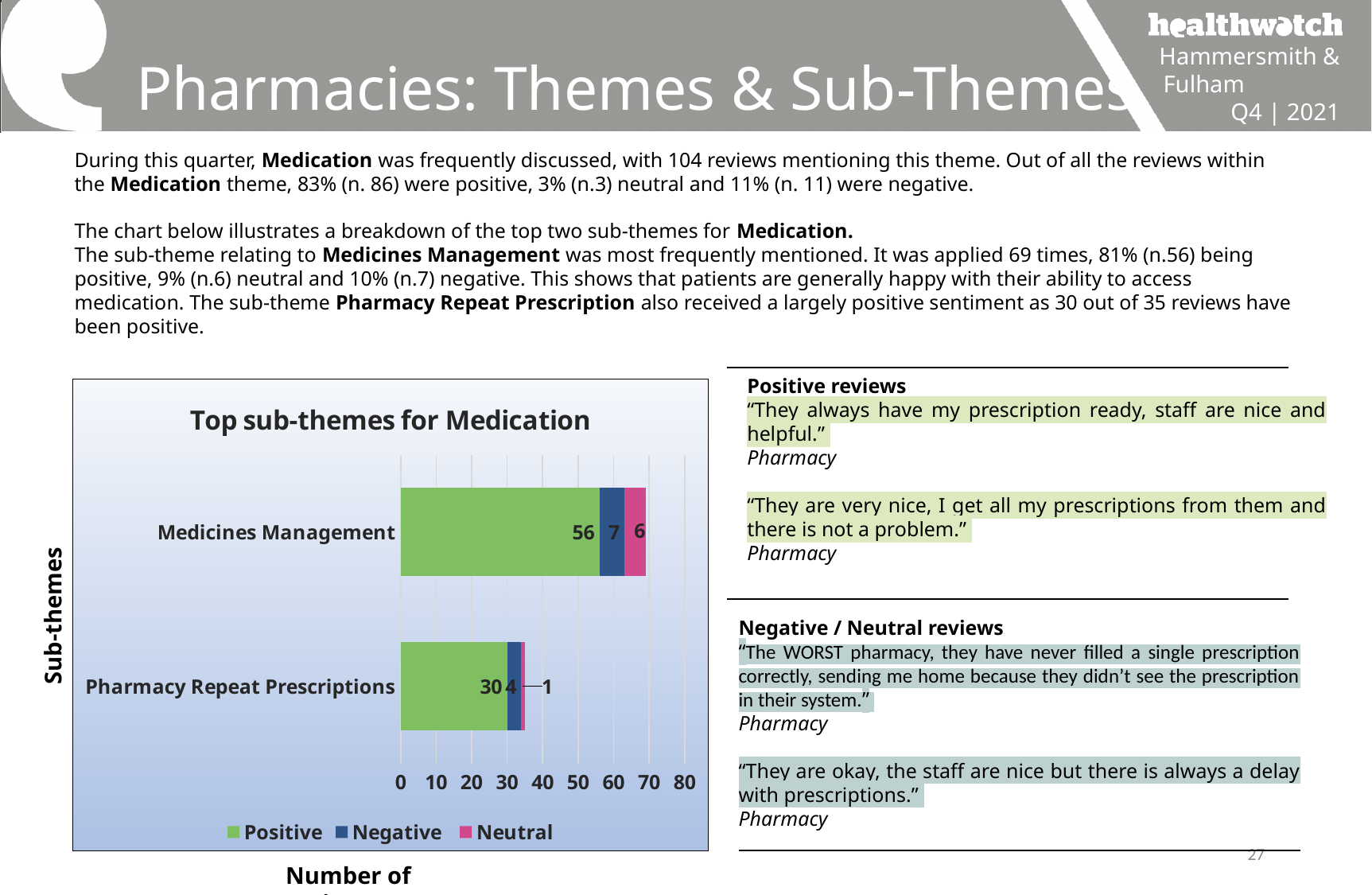
What is the total of the stacked bar for Medicines Management? 69 What is the title of the chart on the slide? Top sub-themes for Medication What is the Negative value for Pharmacy Repeat Prescriptions? 4 How many series does the chart legend list? 3 What is the Neutral value for Medicines Management? 6 Which sub-theme has the lowest Neutral value? Pharmacy Repeat Prescriptions What is the difference between the Positive values for Medicines Management and Pharmacy Repeat Prescriptions? 26 What type of chart is shown on the slide? Stacked bar chart What is the Positive value for Medicines Management? 56 How many sub-theme categories are plotted in the chart? 2 Which sub-theme has the higher Negative value? Medicines Management What is the total of the stacked bar for Pharmacy Repeat Prescriptions? 35